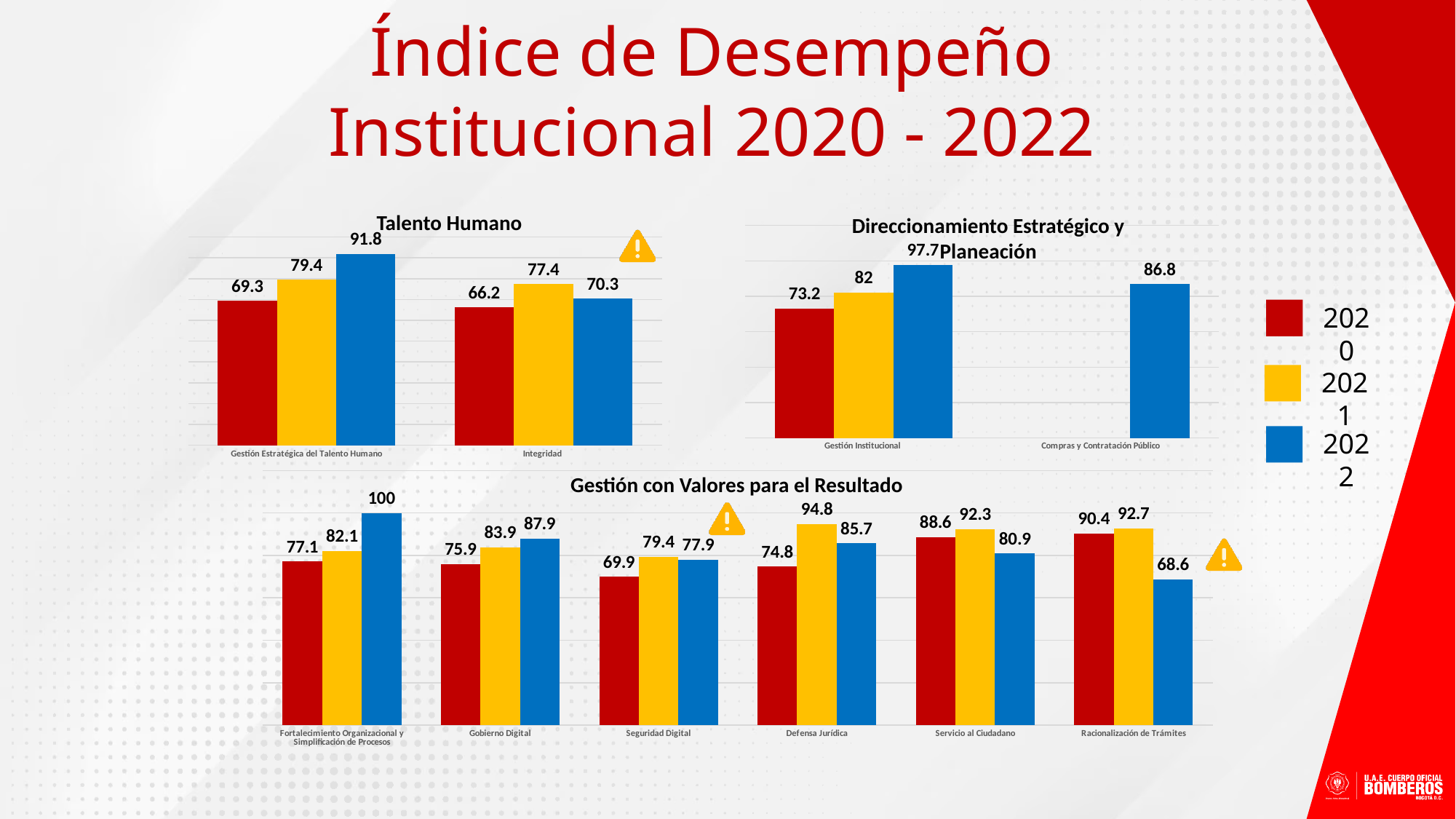
In the 'Direccionamiento Estratégico y Planeación' chart, what is the 2022 value for Compras y Contratación Público? 86.8 How many categories are shown in the 'Gestión con Valores para el Resultado' chart? 6 In the 'Direccionamiento Estratégico y Planeación' chart, what is the 2022 value for Gestión Institucional? 97.7 In the 'Gestión con Valores para el Resultado' chart, which category has the highest 2022 value? Fortalecimiento Organizacional y Simplificación de Procesos In the 'Talento Humano' chart, what is the 2020 value for Integridad? 66.2 In the 'Talento Humano' chart, what is the 2022 value for Gestión Estratégica del Talento Humano? 91.8 What kind of chart is 'Talento Humano'? bar chart In the 'Gestión con Valores para el Resultado' chart, which category has the lowest 2020 value? Seguridad Digital In the 'Talento Humano' chart, which is larger for Integridad: the 2021 value or the 2022 value? 2021 In the 'Gestión con Valores para el Resultado' chart, what is the difference between the 2021 and 2022 values for Racionalización de Trámites? 24.1 In the 'Gestión con Valores para el Resultado' chart, do the values for Defensa Jurídica rise or fall from 2021 to 2022? fall How many series does the legend list? 3